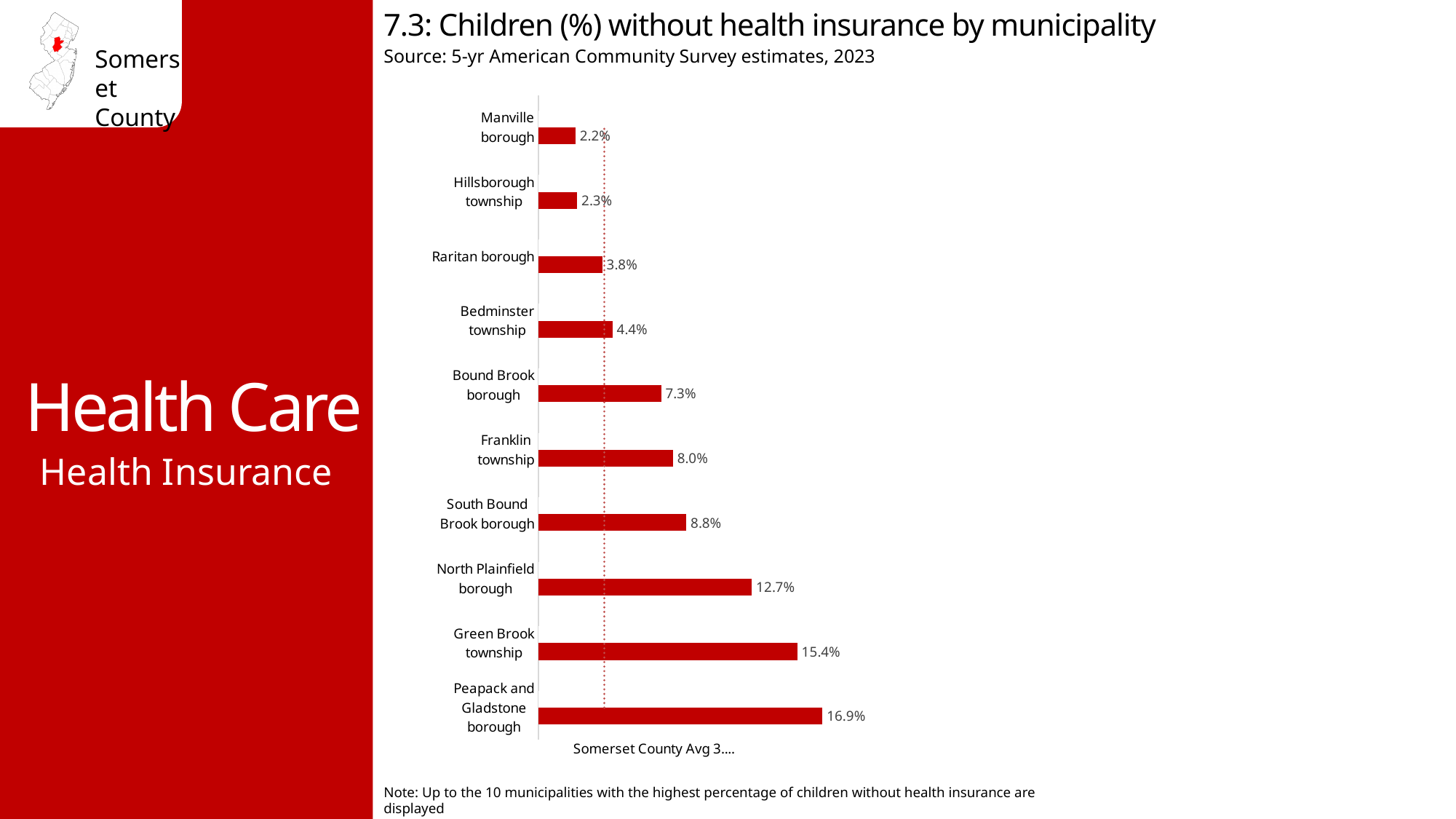
Which has a higher value, South Bound Brook borough or Bedminster township? South Bound Brook borough What kind of chart is shown on the slide? Bar chart What percentage of children are without health insurance in Peapack and Gladstone borough? 16.9% What is the value shown for North Plainfield borough? 12.7% How many municipalities are shown in the chart? 10 What is the difference between the values for Peapack and Gladstone borough and North Plainfield borough? 4.2% What is the difference between the values for Green Brook township and Bound Brook borough? 8.1% Which municipality has the highest percentage of children without health insurance? Peapack and Gladstone borough What does the dotted vertical line in the chart represent? Somerset County Avg Which municipality has the lowest percentage of children without health insurance? Manville borough What is the title of the chart? 7.3: Children (%) without health insurance by municipality What is the value shown for Franklin township? 8.0%